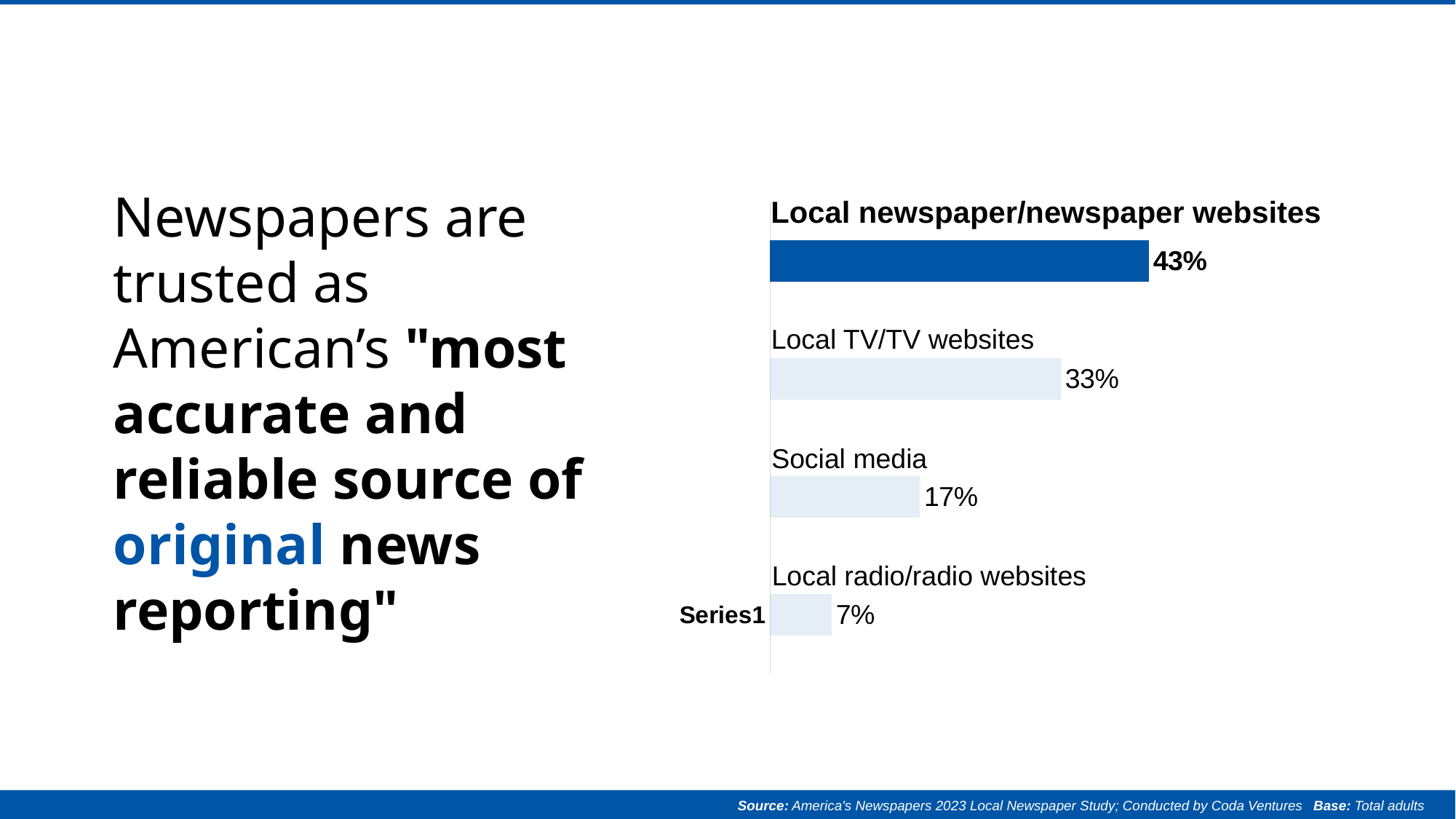
What percentage is shown for Local TV/TV websites? 33% What kind of chart is shown on the slide? Bar chart What is the difference between the values for Local newspaper/newspaper websites and Local TV/TV websites? 10% Which category has the highest value? Local newspaper/newspaper websites Which bar in the chart is drawn in dark blue? Local newspaper/newspaper websites How many categories are shown in the chart? 4 Which category has the lowest value? Local radio/radio websites What percentage is shown for Local radio/radio websites? 7% What percentage is shown for Social media? 17% What is the difference between the values for Social media and Local radio/radio websites? 10% Which is larger, the value for Local TV/TV websites or the value for Social media? Local TV/TV websites What percentage is shown for Local newspaper/newspaper websites? 43%